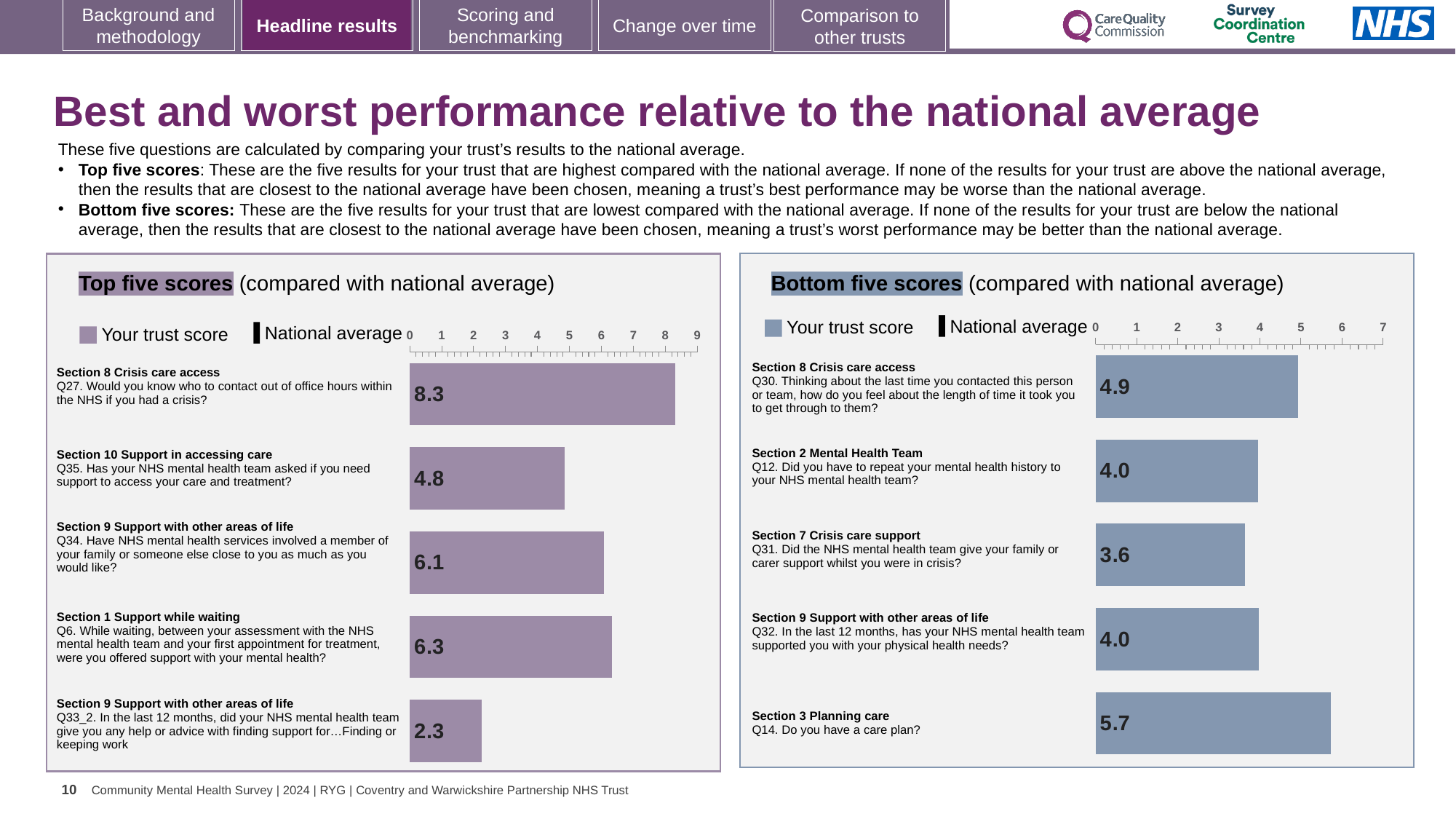
In the Top five scores chart, which has the larger trust score: Q34 or Q6? Q6 What two entries does the legend of the Top five scores chart list? Your trust score and National average In the Top five scores chart, what is the trust score for Q27 (Would you know who to contact out of office hours within the NHS if you had a crisis?)? 8.3 In the Bottom five scores chart, which question has the lowest trust score? Q31 (Section 7 Crisis care support) In the Top five scores chart, which question has the highest trust score? Q27 (Section 8 Crisis care access) In the Bottom five scores chart, which question has the highest trust score? Q14 (Section 3 Planning care) In the Bottom five scores chart, what is the difference between the trust scores for Q14 and Q31? 2.1 In the Top five scores chart, which question has the lowest trust score? Q33_2 (Section 9 Support with other areas of life) What kind of chart is the Top five scores chart? Bar chart How many bars are plotted in the Bottom five scores chart? 5 In the Top five scores chart, what is the difference between the trust scores for Q27 and Q33_2? 6.0 In the Bottom five scores chart, what is the trust score for Q14 (Do you have a care plan?)? 5.7